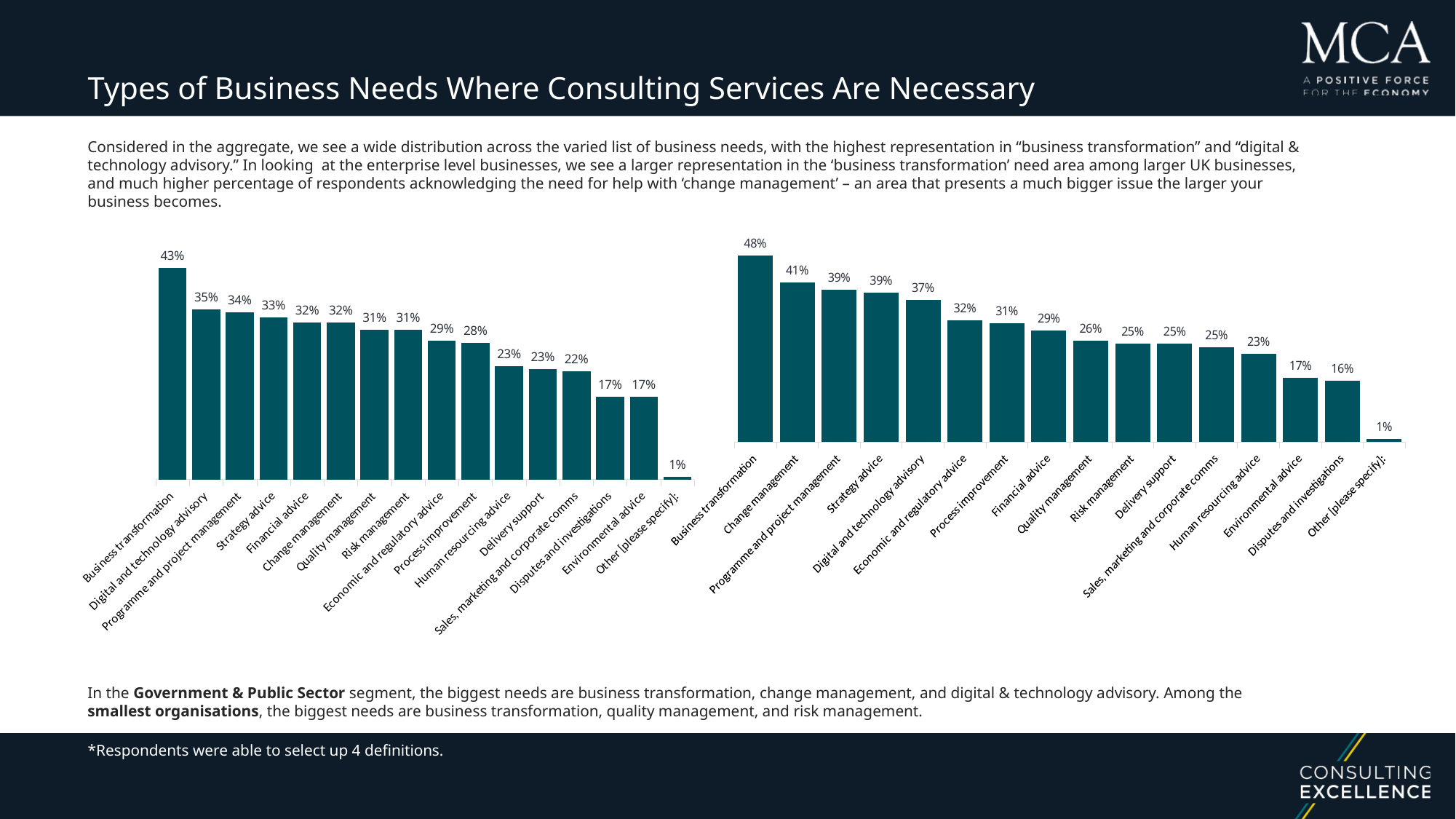
In the right chart, what is the value for Human resourcing advice? 23% In the left chart, what is the difference between Digital and technology advisory and Environmental advice? 18% In the left chart, which category has the lowest value? Other [please specify]: In the left chart, what is the value for Process improvement? 28% How many categories are shown in the right chart? 16 In the left chart, which is larger: Strategy advice or Delivery support? Strategy advice In the right chart, what is the difference between Business transformation and Change management? 7% In the left chart, what is the value for Business transformation? 43% What kind of chart is the left chart? Bar chart In the right chart, what is the value for Change management? 41% In the right chart, do the values rise or fall from left to right along the x axis? Fall In the right chart, which category has the highest value? Business transformation